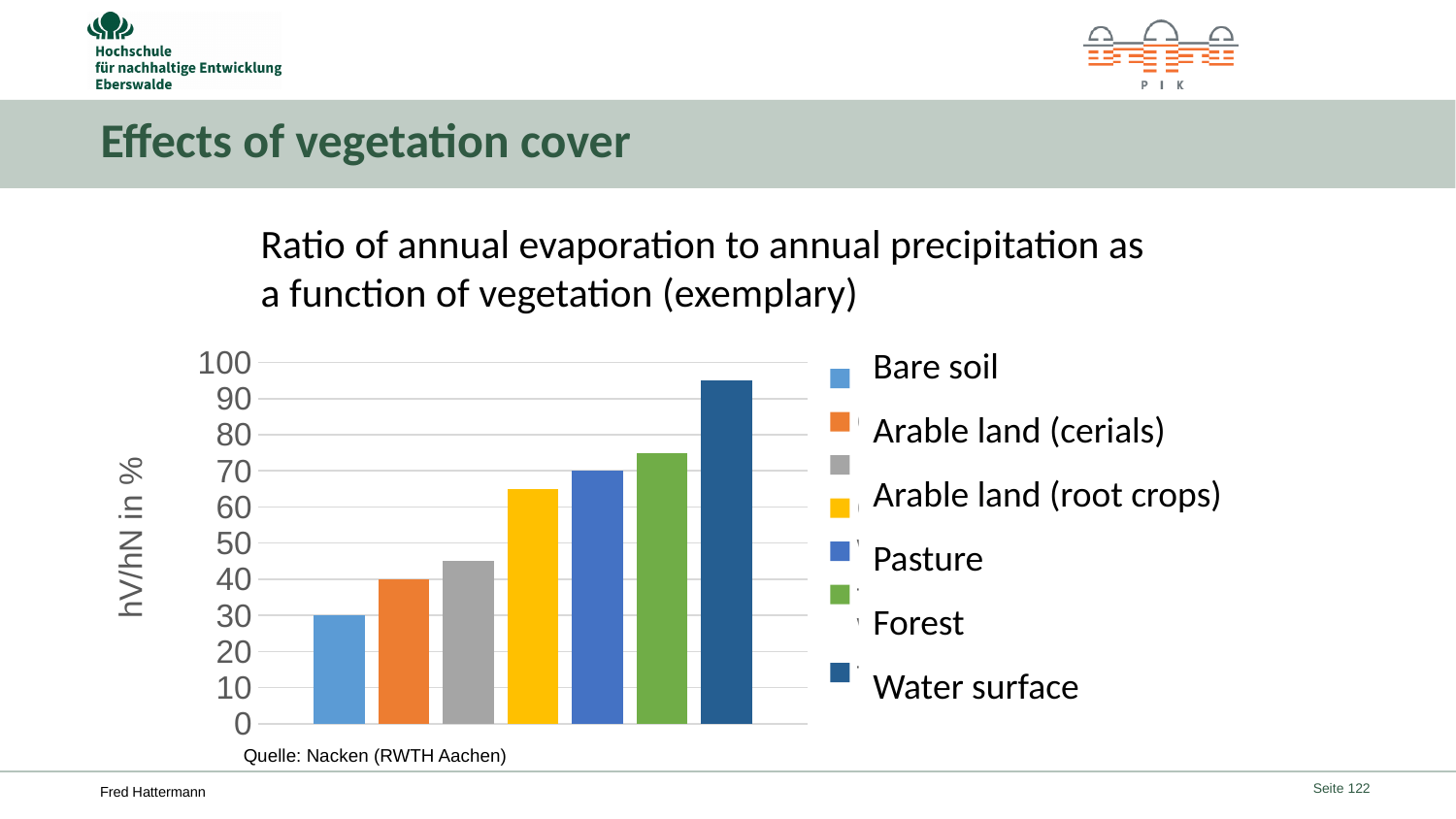
What is the difference between the values for Pasture and Bare soil? 40 Is the value for Forest greater or less than 80? less What kind of chart is shown on the slide? Bar chart Which category has the highest value in the chart? Water surface What is the value for Pasture? 70 Is the value for Water surface greater or less than 90? greater How many bars are plotted in the chart? 7 What is the label on the vertical axis of the chart? hV/hN in % Which is larger, the value for Water surface or the value for Forest? Water surface Which category has the lowest value in the chart? Bare soil What is the value for Bare soil? 30 What is the value for Arable land (cerials)? 40